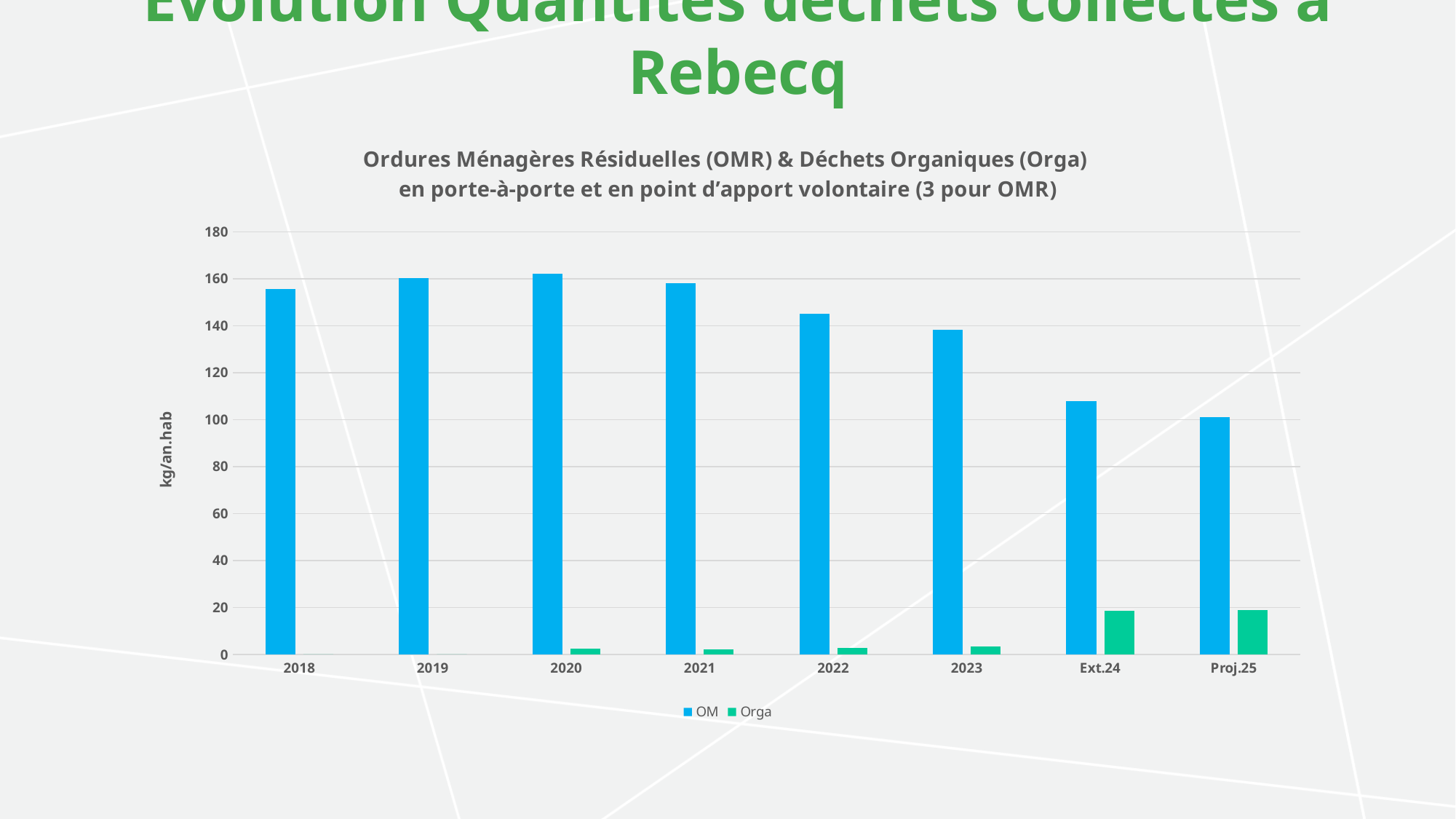
Which is larger, the OM value for 2018 or the OM value for 2022? 2018 How many series does the legend list? 2 How many categories are shown along the x axis? 8 Is the OM value for Ext.24 greater or less than 120? less Is the OM value for 2023 greater or less than 120? greater What kind of chart is shown on the slide? bar chart Do the OM values generally rise or fall from 2020 to Proj.25? fall What is the label on the vertical axis? kg/an.hab Which is larger, the Orga value for 2020 or the Orga value for Ext.24? Ext.24 Which category has the lowest OM value? Proj.25 Is the OM value for 2022 greater or less than 140? greater